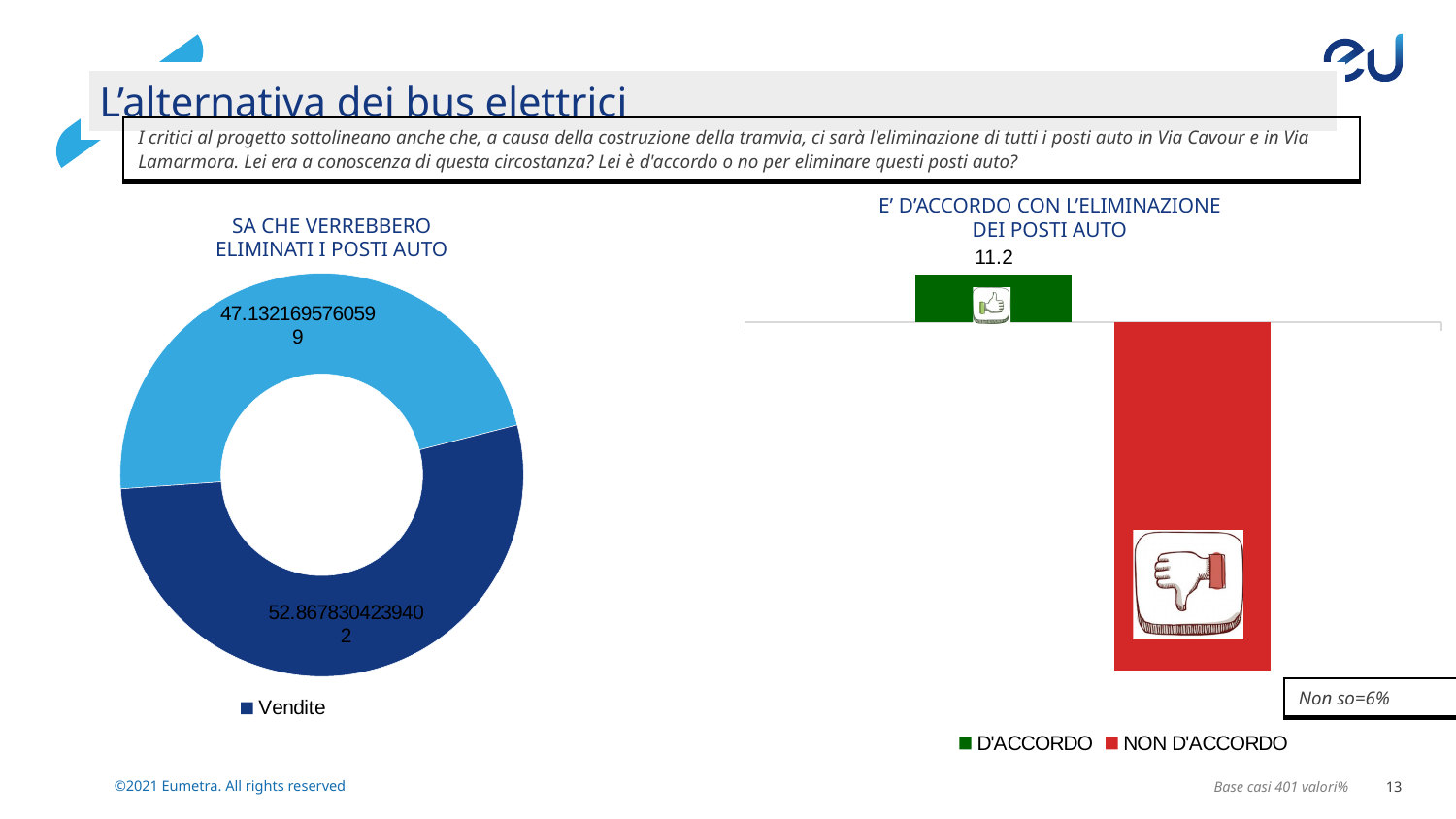
In the right chart 'E' D'ACCORDO CON L'ELIMINAZIONE DEI POSTI AUTO', is the value for D'ACCORDO greater or less than 20? less What kind of chart is the left chart titled 'SA CHE VERREBBERO ELIMINATI I POSTI AUTO'? doughnut chart In the right chart 'E' D'ACCORDO CON L'ELIMINAZIONE DEI POSTI AUTO', what is the value for D'ACCORDO? 11.2 How many slices does the left chart 'SA CHE VERREBBERO ELIMINATI I POSTI AUTO' have? 2 What is the only entry in the legend of the left chart 'SA CHE VERREBBERO ELIMINATI I POSTI AUTO'? Vendite In the right chart 'E' D'ACCORDO CON L'ELIMINAZIONE DEI POSTI AUTO', what colour is the NON D'ACCORDO bar? red According to the note next to the right chart, what is the value for 'Non so'? 6% How many series does the legend of the right chart 'E' D'ACCORDO CON L'ELIMINAZIONE DEI POSTI AUTO' list? 2 What kind of chart is the right chart titled 'E' D'ACCORDO CON L'ELIMINAZIONE DEI POSTI AUTO'? bar chart In the left chart 'SA CHE VERREBBERO ELIMINATI I POSTI AUTO', what is the value of the larger slice? 52.8678304239402 In the left chart 'SA CHE VERREBBERO ELIMINATI I POSTI AUTO', what is the value of the smaller slice? 47.1321695760599 In the right chart 'E' D'ACCORDO CON L'ELIMINAZIONE DEI POSTI AUTO', which bar is larger, D'ACCORDO or NON D'ACCORDO? NON D'ACCORDO